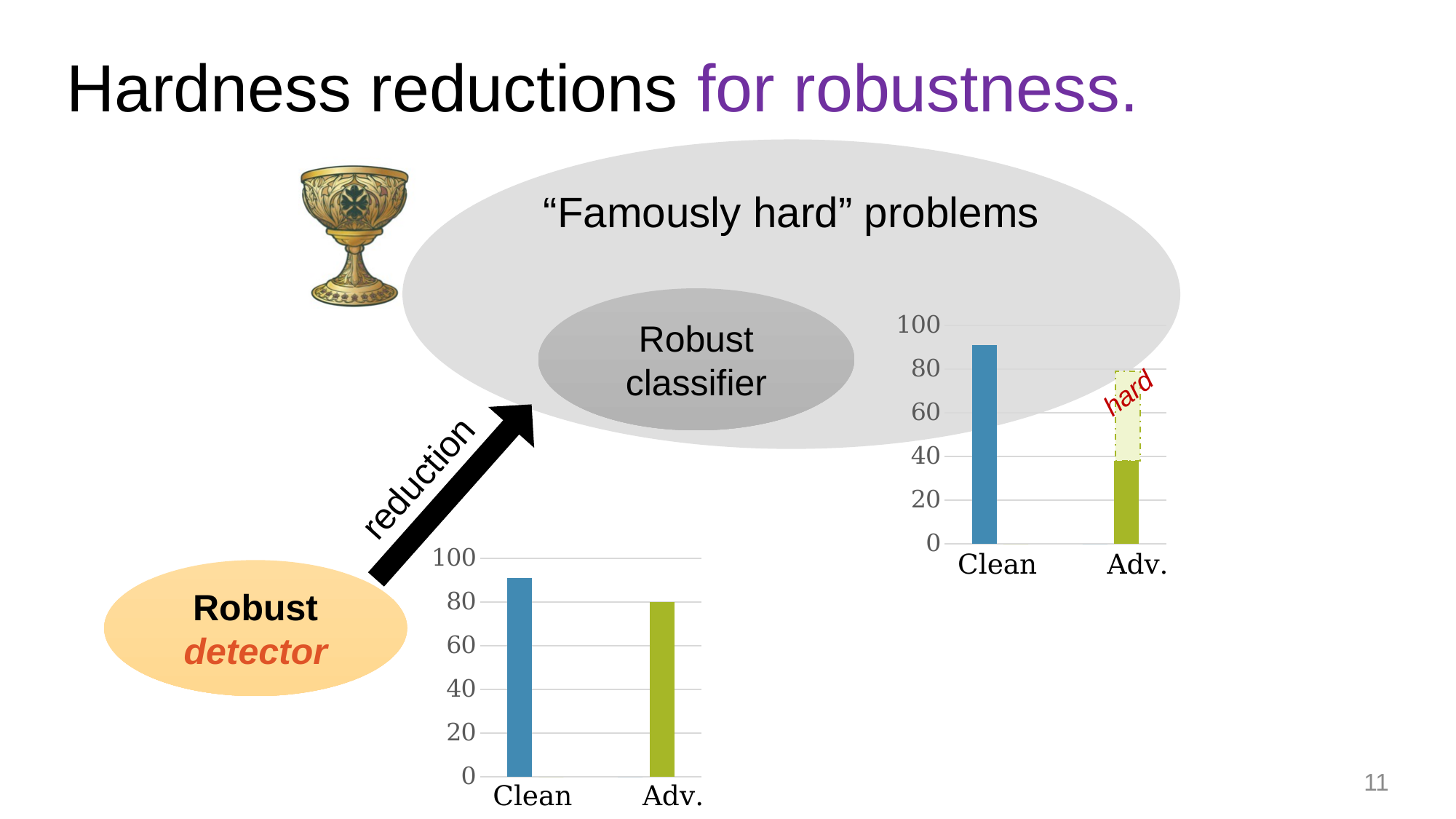
In the chart on the right of the slide, is the solid bar for Adv. greater or less than 60? less In the bottom-left chart, is the value for Clean greater or less than 80? greater In the bottom-left chart, is the value for Adv. greater or less than 60? greater In the chart on the right of the slide, which category has the lowest solid bar? Adv. How many categories does the bottom-left chart show on its x axis? 2 What is the maximum value shown on the y axis of the chart on the right of the slide? 100 How many categories does the chart on the right of the slide show on its x axis? 2 In the bottom-left chart, which category has the higher bar, Clean or Adv.? Clean In the chart on the right of the slide, which category has the highest bar? Clean What kind of chart is the chart at the bottom left of the slide? bar chart What word is written in red over the dashed portion of the Adv. bar in the chart on the right? hard